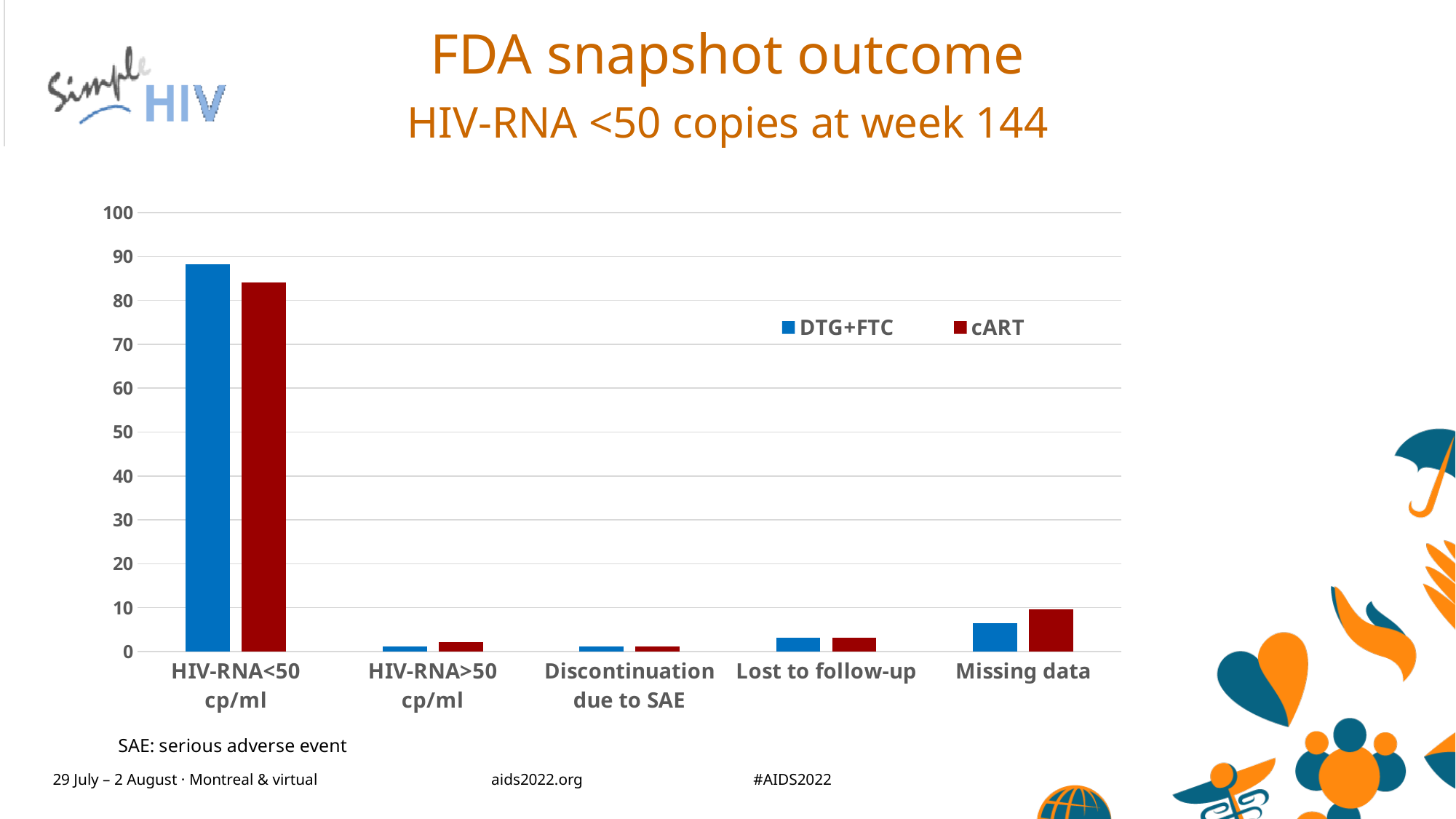
What colour are the bars for the cART series? dark red Is the cART value for Missing data greater or less than 20? less Is the cART value for HIV-RNA<50 cp/ml greater or less than 90? less What kind of chart is shown on the slide? bar chart Is the DTG+FTC value for HIV-RNA<50 cp/ml greater or less than 80? greater For HIV-RNA<50 cp/ml, which series has the larger value, DTG+FTC or cART? DTG+FTC What is the main title of the slide above the chart? FDA snapshot outcome For Missing data, which series has the larger value, DTG+FTC or cART? cART Which category has the highest value for the DTG+FTC series? HIV-RNA<50 cp/ml How many categories are shown on the x axis of the chart? 5 How many series does the chart legend list? 2 Which category has the highest value for the cART series? HIV-RNA<50 cp/ml